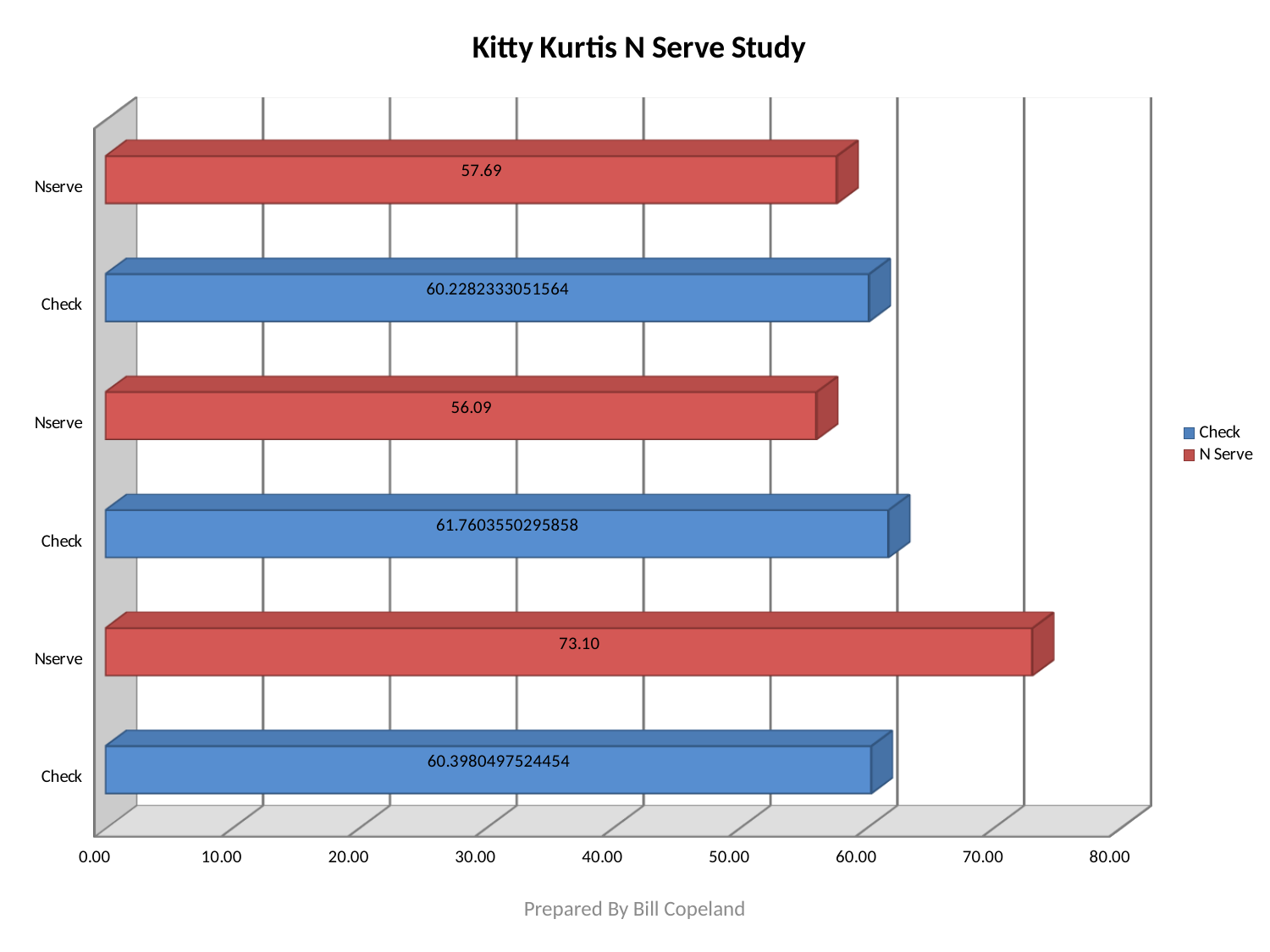
What is the difference between the highest Nserve value (73.10) and the lowest Nserve value (56.09)? 17.01 How many bars are plotted in the chart? 6 What is the value of the Nserve bar that is second from the bottom? 73.10 Which bar has the highest value in the chart? Nserve (73.10) What is the value of the topmost bar (Nserve)? 57.69 What type of chart is shown on the slide? bar chart Which bar has the lowest value in the chart? Nserve (56.09) What is the value of the bottom bar (Check)? 60.3980497524454 What is the title of the chart? Kitty Kurtis N Serve Study What is the value of the Nserve bar in the middle of the chart (third from the top)? 56.09 Is the value of the Nserve bar second from the bottom greater or less than 70.00? greater How many series does the legend list? 2